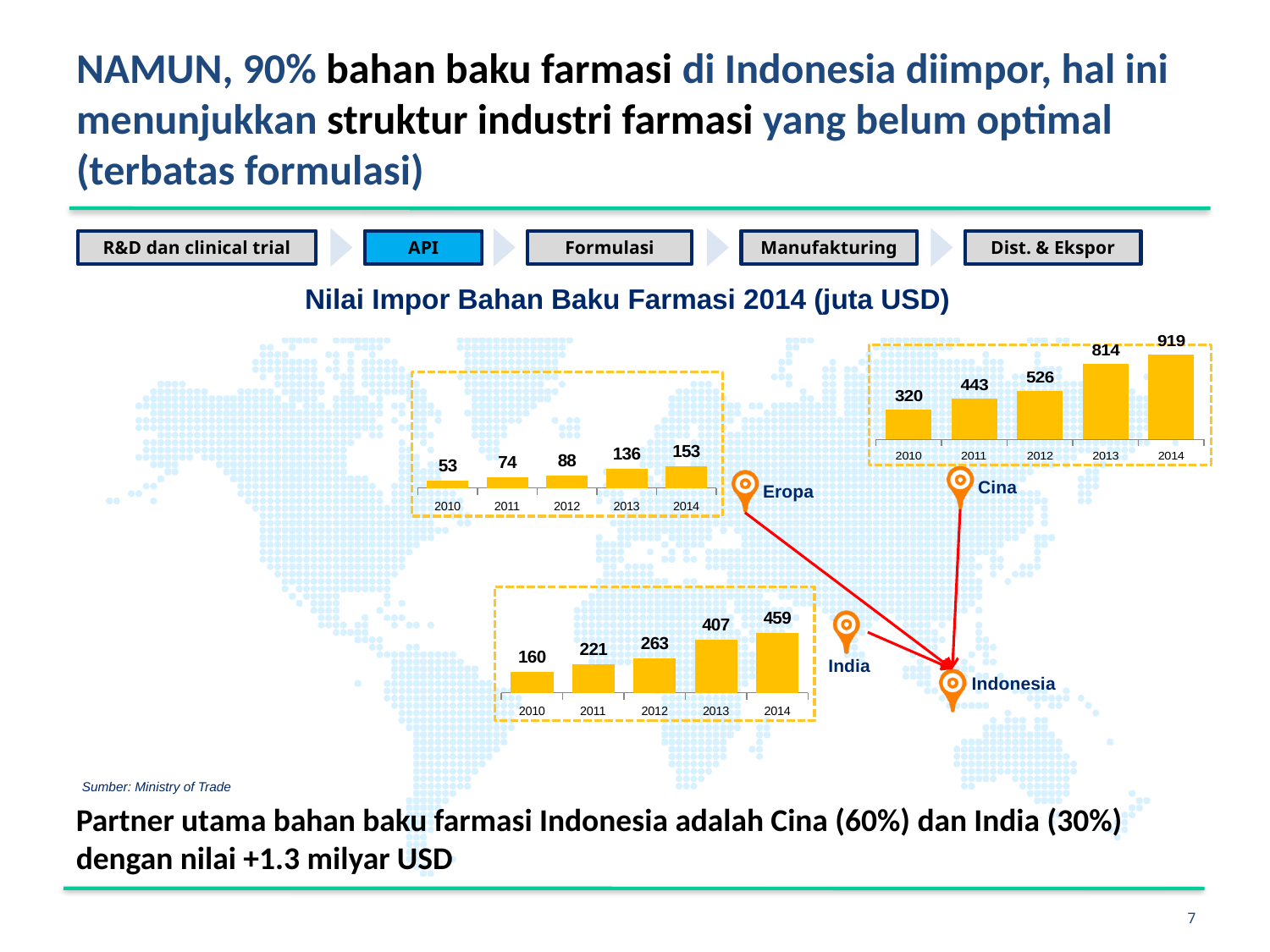
How many years are shown in the Cina chart? 5 In the Cina chart, which year has the highest value? 2014 In the India chart, what is the value for 2010? 160 In the Eropa chart, which year has the lowest value? 2010 In the Cina chart, what is the value for 2012? 526 Which is larger: the 2014 value in the India chart or the 2014 value in the Eropa chart? India (459) What is the title shown above the three charts? Nilai Impor Bahan Baku Farmasi 2014 (juta USD) In the Eropa chart, what is the value for 2014? 153 In the India chart, what is the difference between the 2013 and 2012 values? 144 What type of chart is the India chart? Bar chart In the Cina chart, what is the difference between the 2014 and 2010 values? 599 In the Eropa chart, do the values rise or fall from 2010 to 2014? Rise